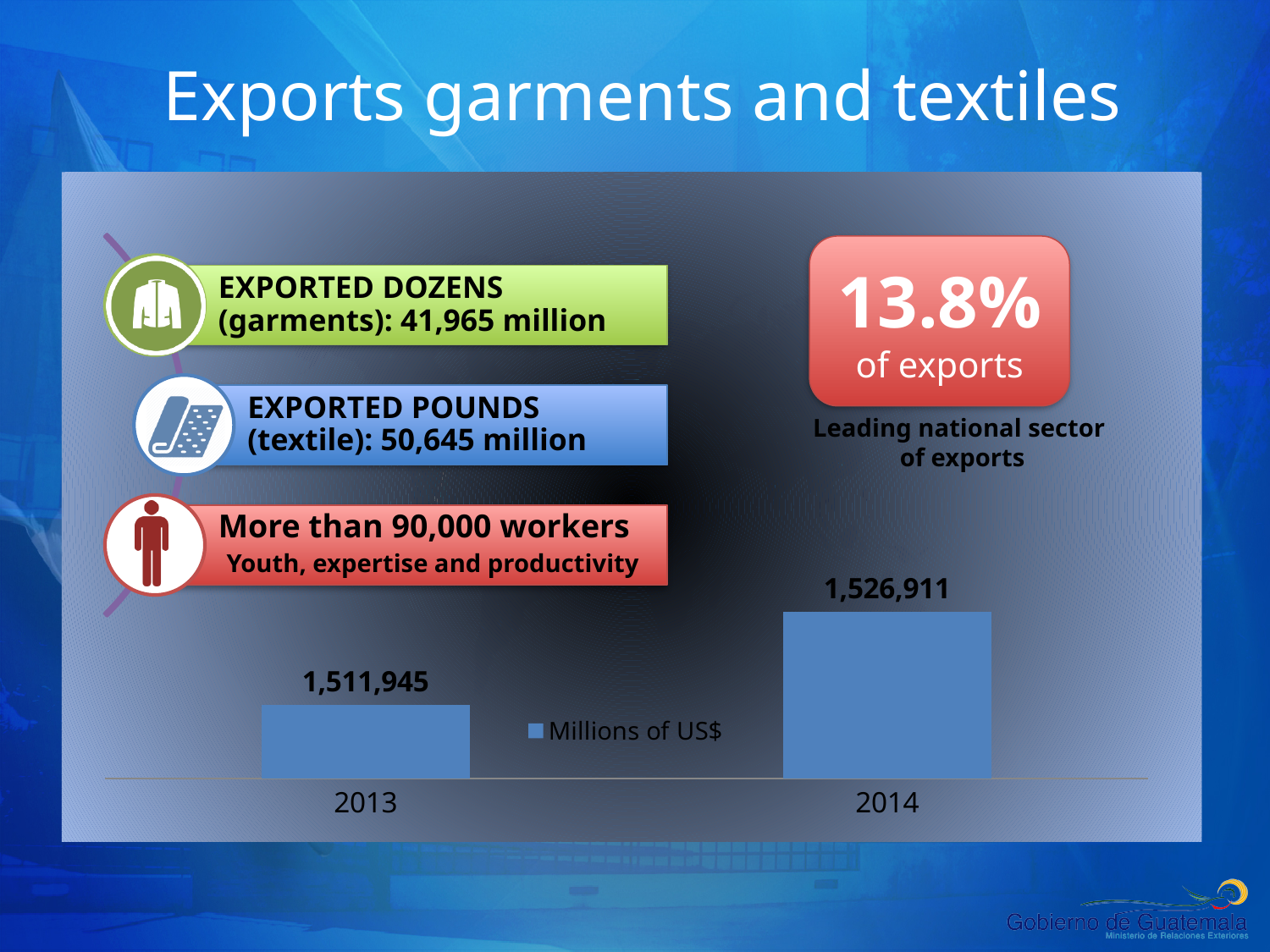
What colour are the bars in the chart? blue Is the value for 2014 larger or smaller than the value for 2013? larger Which year has the lower value in the bar chart? 2013 What is the difference between the 2014 and 2013 values in the bar chart? 14,966 What is the series name shown in the chart legend? Millions of US$ Do the values rise or fall from 2013 to 2014? rise What kind of chart is shown on the slide? bar chart What is the value for 2014 in the bar chart? 1,526,911 How many series does the chart legend list? 1 What is the value for 2013 in the bar chart? 1,511,945 Which year has the higher value in the bar chart? 2014 How many bars are shown in the chart? 2